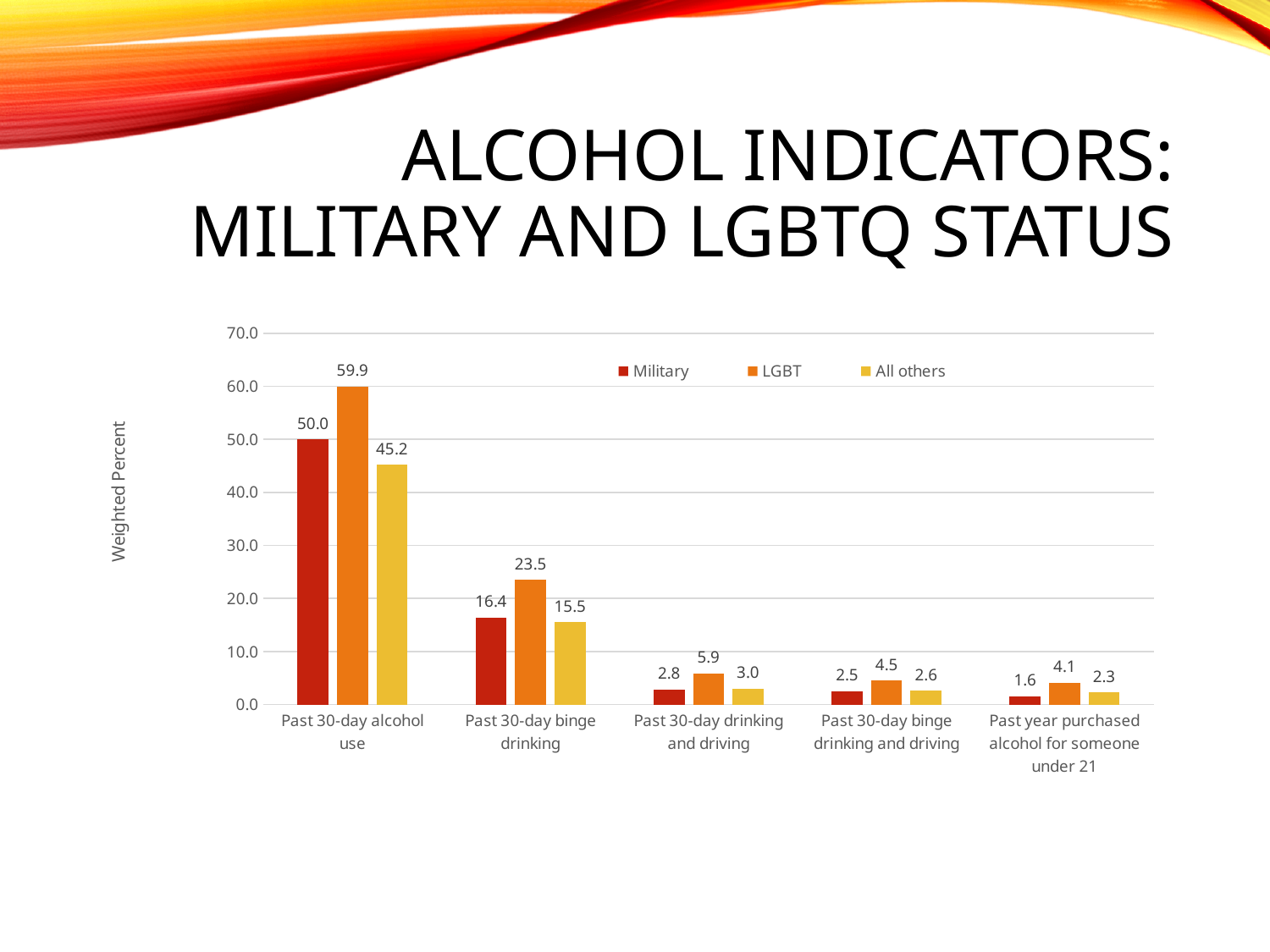
What is the Military value for Past 30-day binge drinking? 16.4 Which category has the lowest Military value? Past year purchased alcohol for someone under 21 Is the All others value for Past 30-day alcohol use greater or less than 40.0? greater What is the difference between the LGBT and Military values for Past 30-day alcohol use? 9.9 How many series does the legend list? 3 What is the label of the y axis? Weighted Percent How many categories are shown on the x axis? 5 What kind of chart is shown on the slide? Bar chart Which category has the highest LGBT value? Past 30-day alcohol use What is the All others value for Past year purchased alcohol for someone under 21? 2.3 What is the LGBT value for Past 30-day alcohol use? 59.9 For Past 30-day binge drinking, which is larger: the LGBT value or the All others value? LGBT